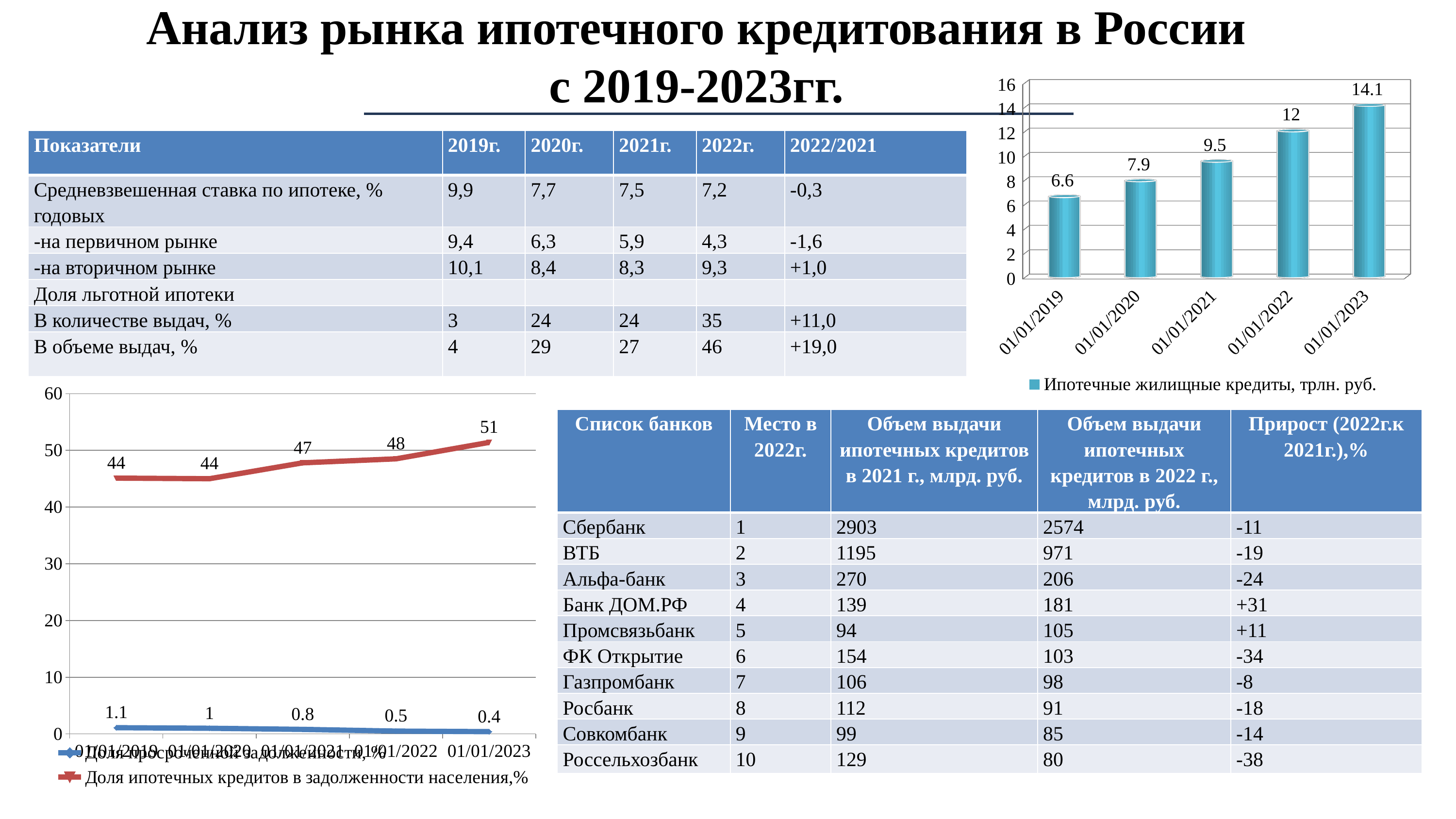
How many bars are shown in the bar chart at the top right? 5 In the line chart at the bottom left, what is the difference between the values of the red series at 01/01/2023 and 01/01/2019? 7 In the bar chart at the top right, what is the value for 01/01/2020? 7.9 In the bar chart at the top right, do the values rise or fall from 01/01/2019 to 01/01/2023? rise In the bar chart at the top right, what is the difference between the values for 01/01/2023 and 01/01/2019? 7.5 In the bar chart at the top right, what is the value for 01/01/2023? 14.1 What series name does the legend of the bar chart at the top right show? Ипотечные жилищные кредиты, трлн. руб. In the bar chart at the top right, which date has the highest value? 01/01/2023 In the bar chart at the top right, which date has the lowest value? 01/01/2019 In the line chart at the bottom left, what is the value of the series 'Доля ипотечных кредитов в задолженности населения,%' at 01/01/2023? 51 How many series does the legend of the line chart at the bottom left list? 2 What kind of chart is shown at the bottom left of the slide? line chart